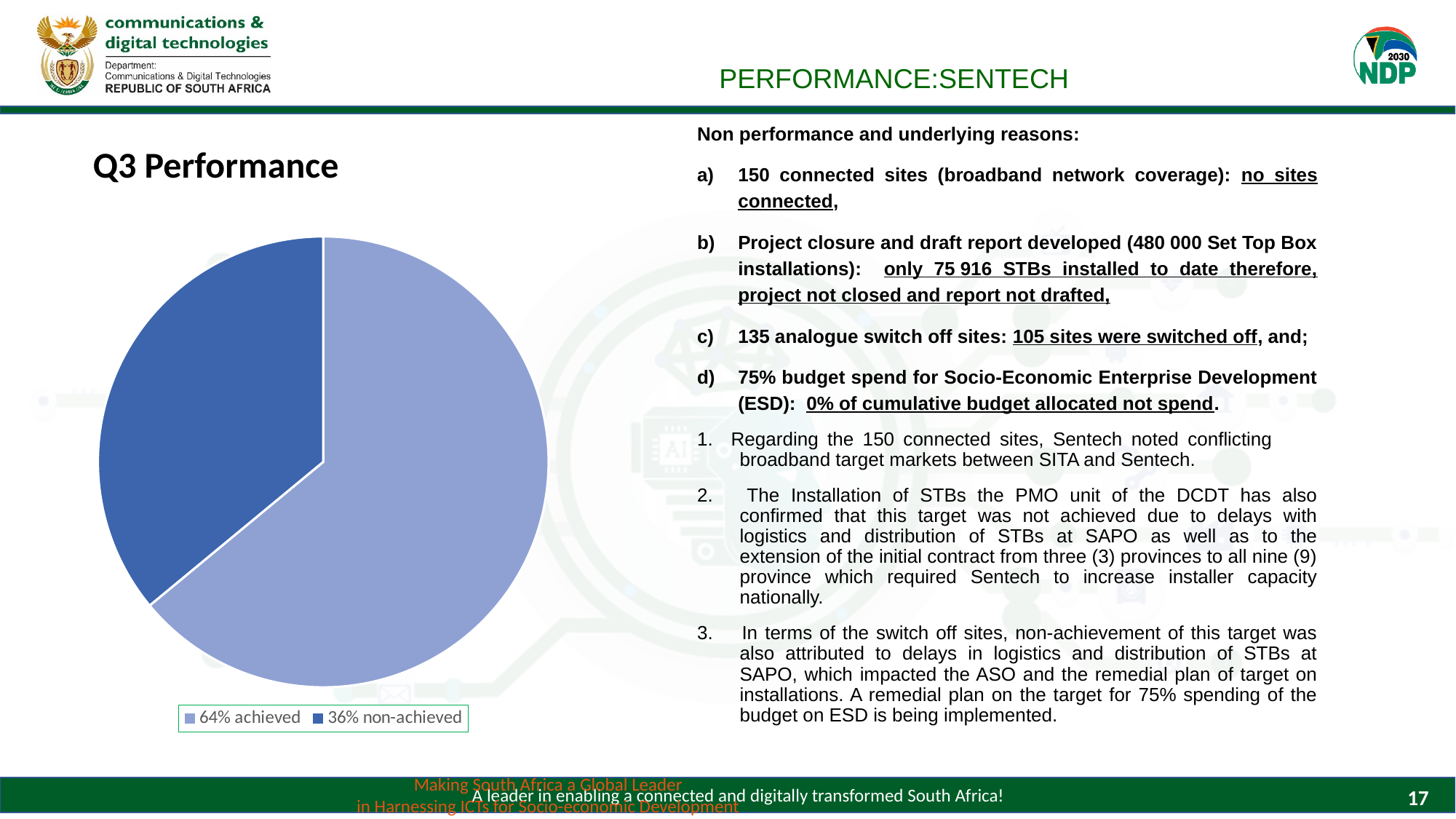
According to the legend, what share of the pie is achieved? 64% Which legend entry is shown in the darker blue colour? 36% non-achieved Which slice of the pie is the largest? 64% achieved Which slice of the pie is the smallest? 36% non-achieved What kind of chart is shown on the slide? pie chart According to the legend, what share of the pie is non-achieved? 36% What is the difference in percentage points between the achieved and non-achieved shares? 28 Which is larger, the achieved slice or the non-achieved slice? achieved How many slices does the pie chart have? 2 What is the title of the chart? Q3 Performance How many entries does the chart legend list? 2